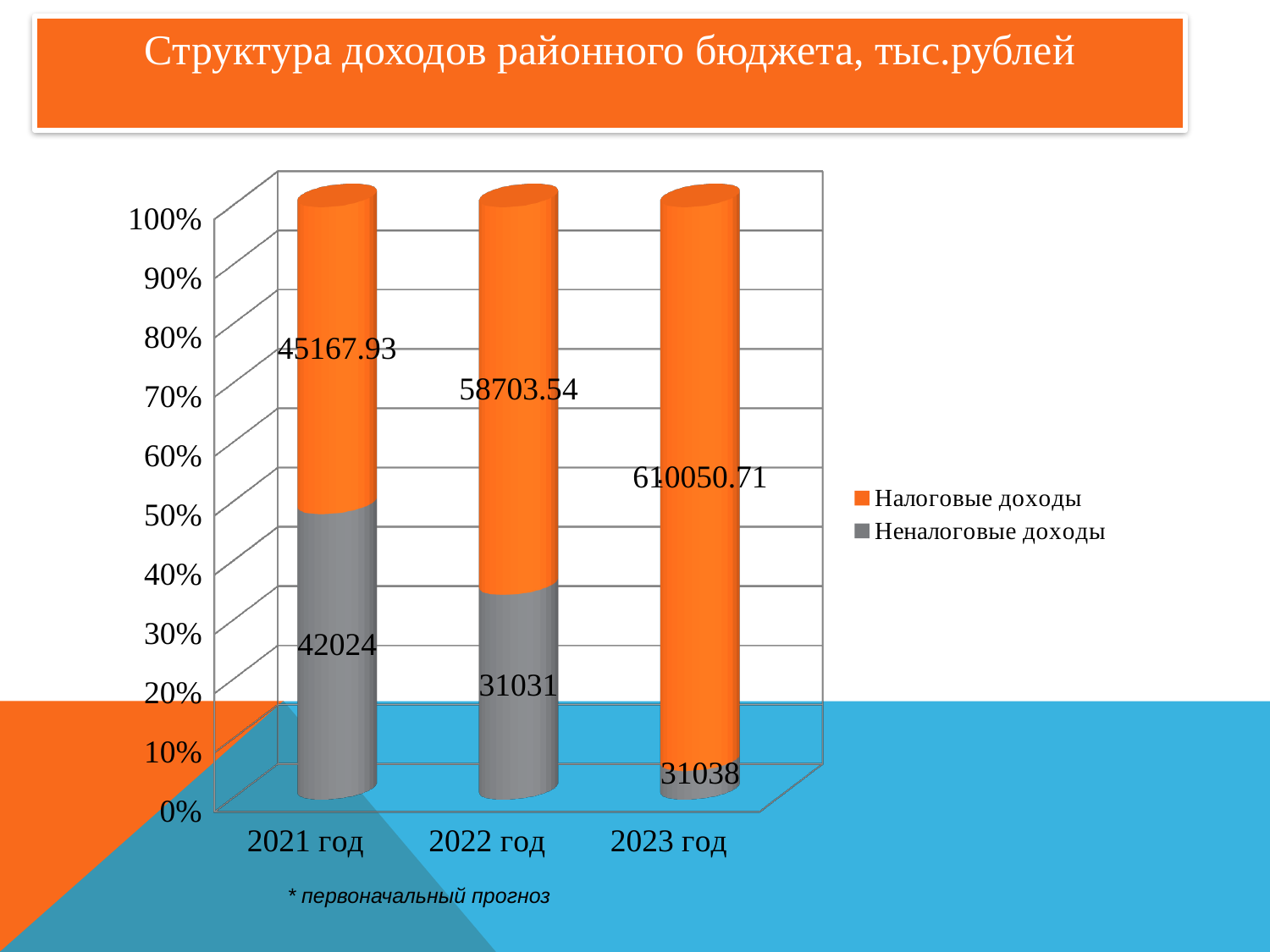
What is the value of Налоговые доходы for 2021 год? 45167.93 What is the title of the chart? Структура доходов районного бюджета, тыс.рублей Does the share of Неналоговые доходы rise or fall from 2021 год to 2023 год? Fall What is the value of Налоговые доходы for 2022 год? 58703.54 What type of chart is shown on the slide? Stacked bar chart What is the value of Неналоговые доходы for 2023 год? 31038 Is the share of Неналоговые доходы in 2023 год greater or less than 10%? less How many series does the legend list? 2 Which year has the highest value of Неналоговые доходы? 2021 год What is the value of Неналоговые доходы for 2021 год? 42024 How many years are shown on the x axis? 3 What is the difference between Налоговые доходы and Неналоговые доходы in 2022 год? 27672.54